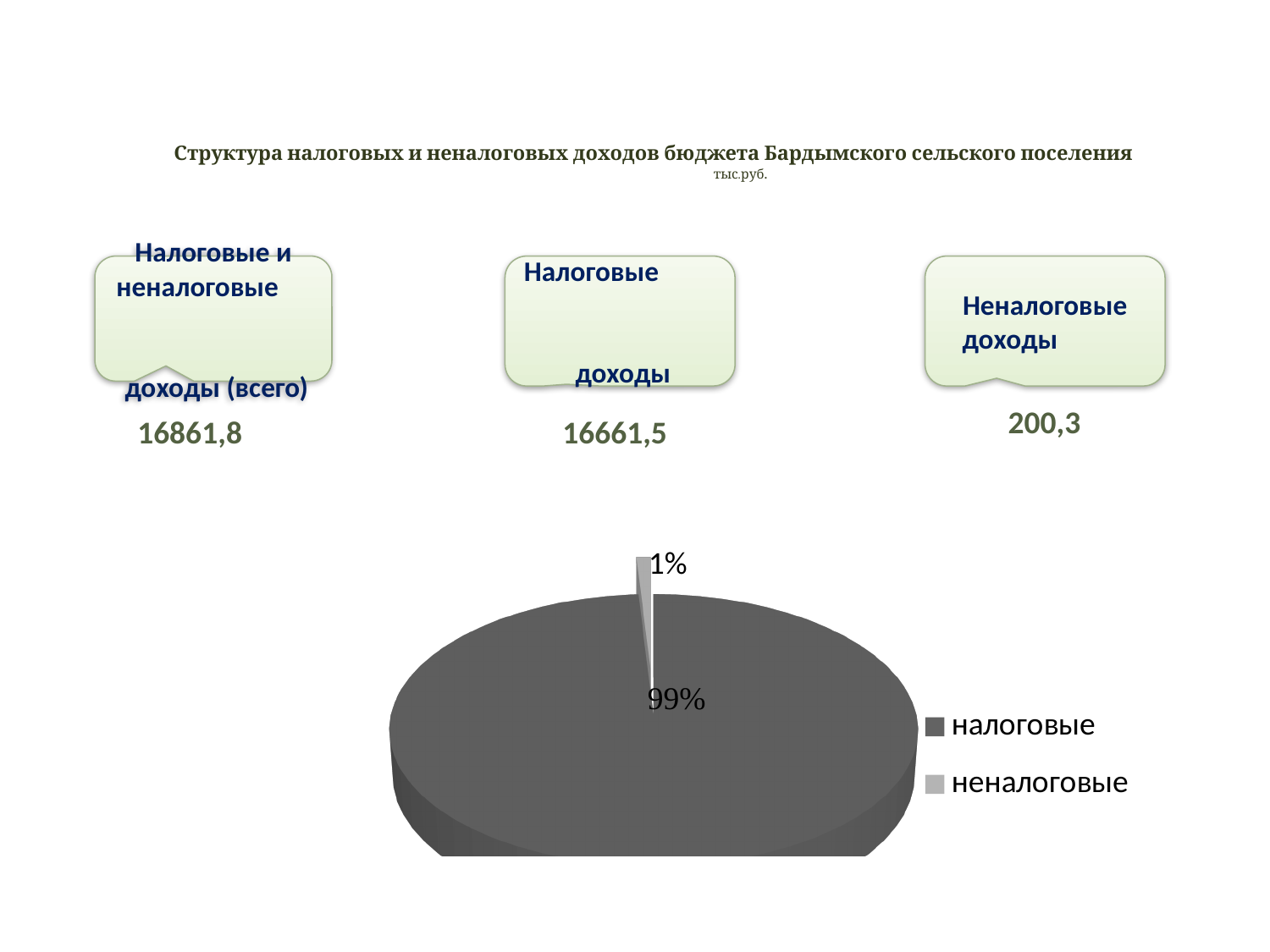
Which slice of the pie chart is the largest? налоговые What kind of chart is shown on the slide? pie chart What share of the pie does the slice for неналоговые represent? 1% How many slices does the pie chart have? 2 Which slice of the pie chart is the smallest? неналоговые How many entries does the legend of the pie chart list? 2 Which legend entry is shown in dark grey in the pie chart? налоговые What is the difference in percentage points between the налоговые slice and the неналоговые slice? 98 What share of the pie does the slice for налоговые represent? 99% Which legend entry is shown in light grey in the pie chart? неналоговые Which is larger in the pie chart, the share for налоговые or the share for неналоговые? налоговые